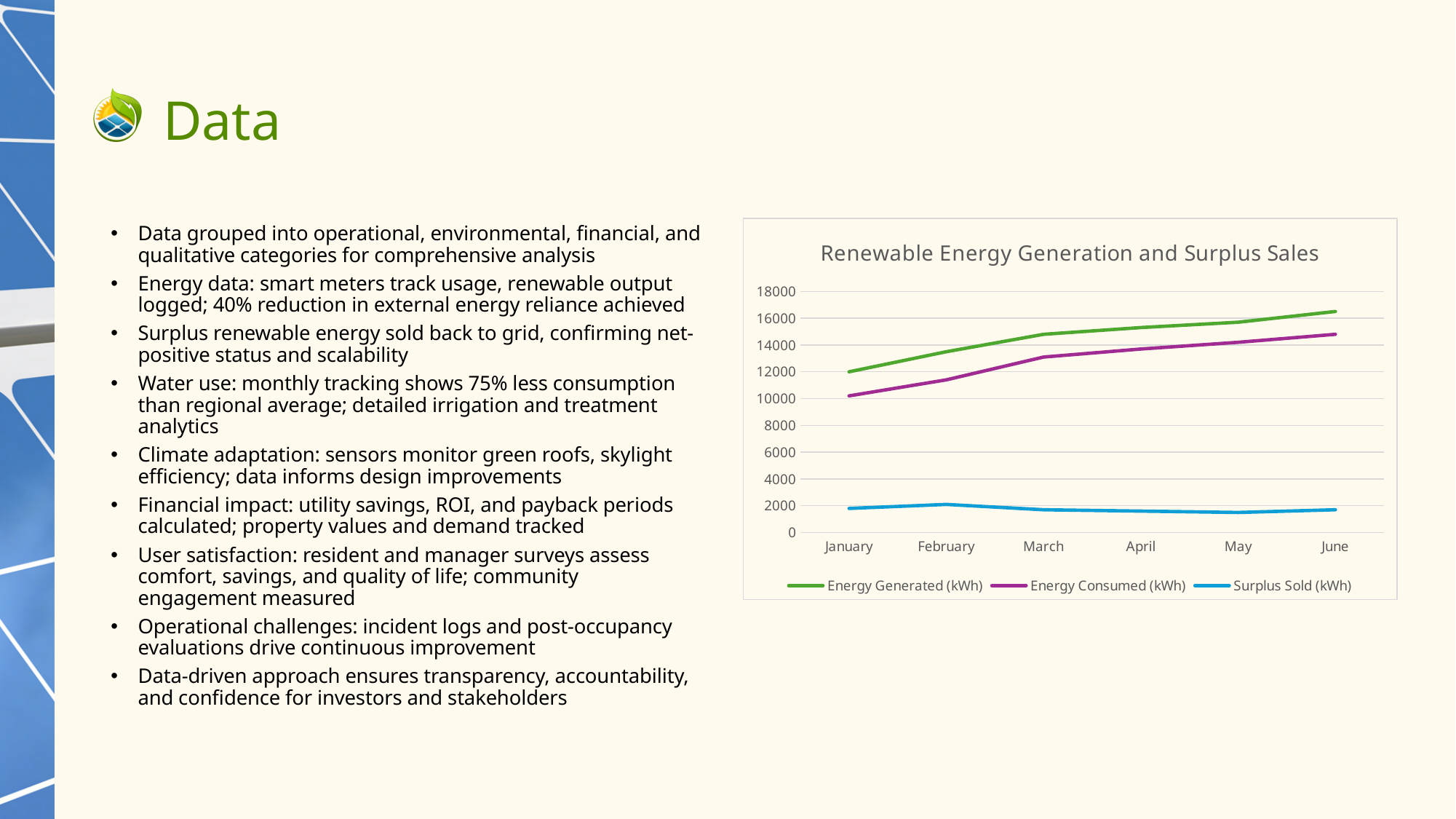
Does the Energy Generated (kWh) series rise or fall from January to June? rise Is the value for Energy Generated (kWh) in June greater or less than 16000? greater How many series does the chart's legend list? 3 What kind of chart is shown on the slide? line chart In which month is Energy Consumed (kWh) lowest? January Is the value for Surplus Sold (kWh) in February greater or less than 4000? less How many months are plotted along the x axis of the chart? 6 Is the value for Energy Consumed (kWh) in January greater or less than 12000? less Which series is drawn in green on the chart? Energy Generated (kWh) What is the title of the chart? Renewable Energy Generation and Surplus Sales In which month is Energy Generated (kWh) highest? June In March, which is larger: Energy Generated (kWh) or Energy Consumed (kWh)? Energy Generated (kWh)